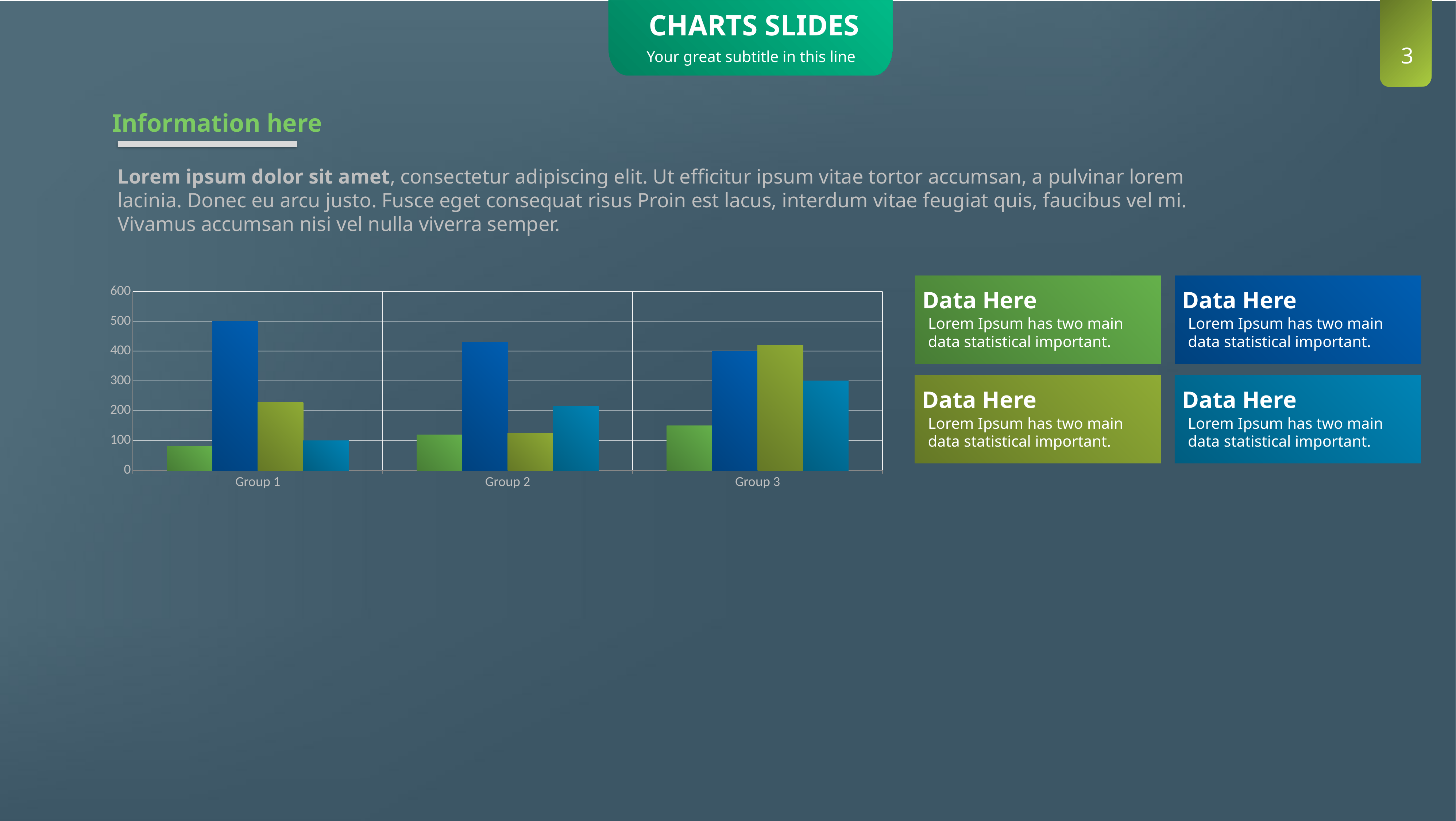
Which is larger: the dark blue bar for Group 1 or the dark blue bar for Group 2? Group 1 What is the value of the light blue bar for Group 3? 300 Do the values of the green bars rise or fall from Group 1 to Group 3? rise How many bars are plotted for each group in the chart? 4 Which group contains the shortest bar in the chart? Group 1 Which group has the tallest bar in the chart? Group 1 How many groups (categories) are shown on the x axis of the chart? 3 Is the value of the green bar for Group 3 greater or less than 200? less Is the value of the dark blue bar for Group 2 greater or less than 400? greater What kind of chart is shown on the slide? bar chart What is the value of the dark blue bar for Group 1? 500